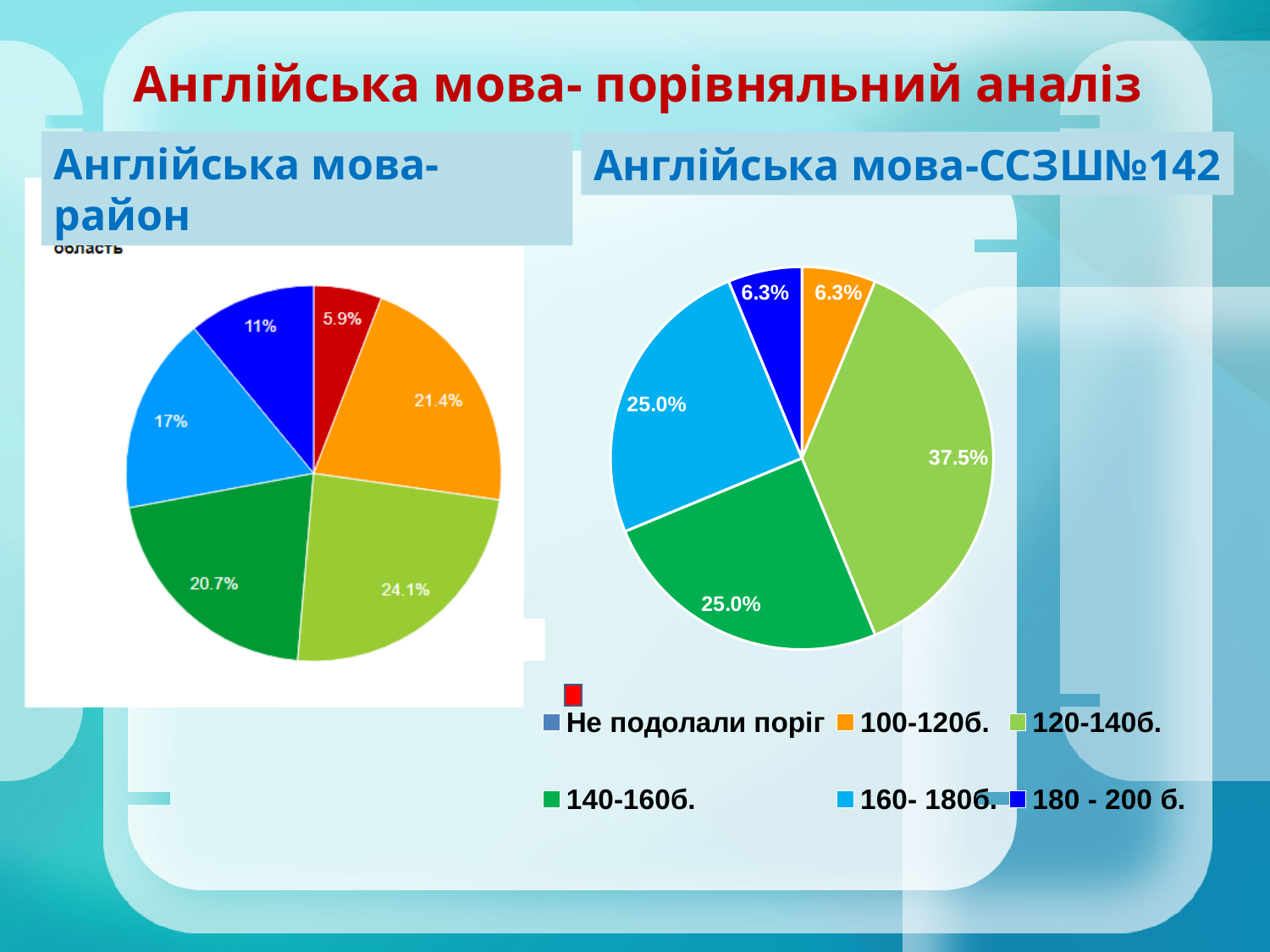
How many slices does the 'Англійська мова-ССЗШ№142' pie chart have? 5 In the 'Англійська мова-район' chart on the left, what is the value of the smallest slice? 5.9% In the 'Англійська мова-ССЗШ№142' chart, what share does the 140-160б. slice have? 25.0% In the 'Англійська мова-ССЗШ№142' chart, which slice is larger: 120-140б. or 160- 180б.? 120-140б. What kind of chart is the 'Англійська мова-ССЗШ№142' chart on the right? pie chart In the 'Англійська мова-ССЗШ№142' chart, what is the difference in percentage points between the 120-140б. slice and the 180 - 200 б. slice? 31.2 In the 'Англійська мова-район' chart on the left, what is the value of the largest slice? 24.1% How many entries does the legend below the 'Англійська мова-ССЗШ№142' chart list? 6 In the 'Англійська мова-район' chart on the left, what value is shown on the dark blue slice? 11% In the 'Англійська мова-ССЗШ№142' chart, which category has the largest slice? 120-140б. How many slices does the 'Англійська мова-район' pie chart on the left have? 6 In the 'Англійська мова-ССЗШ№142' chart, what share does the 120-140б. slice have? 37.5%